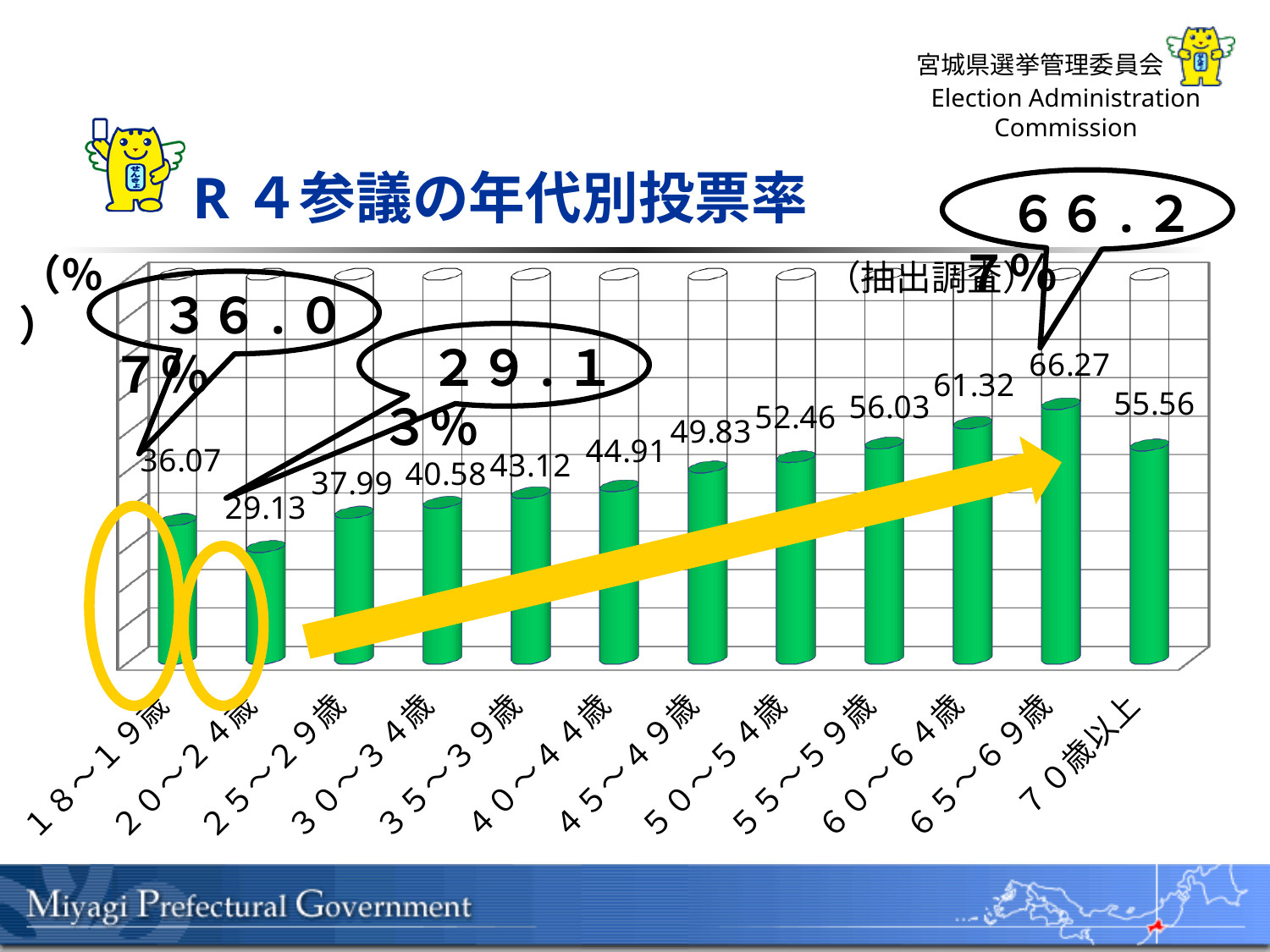
Which age group has the highest turnout value? 65～69歳 How many age groups are plotted on the chart? 12 What is the difference between the values for 18～19歳 and 20～24歳? 6.94 What is the value shown for the 70歳以上 age group? 55.56 What kind of chart is shown on the slide? Bar chart What is the value shown for the 65～69歳 age group? 66.27 Which age group has the lowest turnout value? 20～24歳 What is the title of the chart on the slide? R４参議の年代別投票率 What is the value shown for the 18～19歳 age group? 36.07 Which has a larger value, 60～64歳 or 70歳以上? 60～64歳 What is the voter turnout value shown for the 20～24歳 age group? 29.13 What is the difference between the values for 65～69歳 and 20～24歳? 37.14